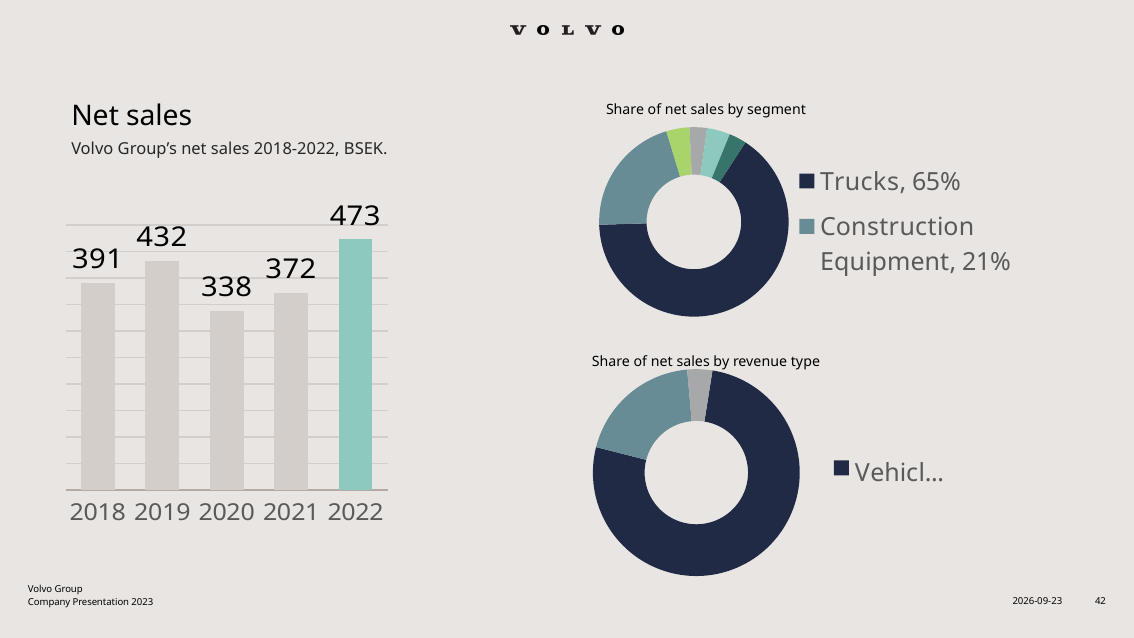
On the Net sales bar chart, what is the difference between net sales in 2022 and 2021? 101 On the Net sales bar chart, which year had the lowest net sales? 2020 On the Net sales bar chart, what was Volvo Group's net sales in 2022? 473 On the Net sales bar chart, how many years are shown? 5 On the 'Share of net sales by segment' chart, what share of net sales does Trucks account for? 65% On the Net sales bar chart, which year had higher net sales, 2018 or 2019? 2019 On the Net sales bar chart, which year had the highest net sales? 2022 On the Net sales bar chart, what was the net sales value for 2020? 338 What kind of chart is the 'Share of net sales by revenue type' chart? Donut (pie) chart What kind of chart is the Net sales chart on the left of the slide? Bar chart On the Net sales bar chart, did net sales rise or fall from 2019 to 2020? Fall On the 'Share of net sales by segment' chart, what share of net sales does Construction Equipment account for? 21%